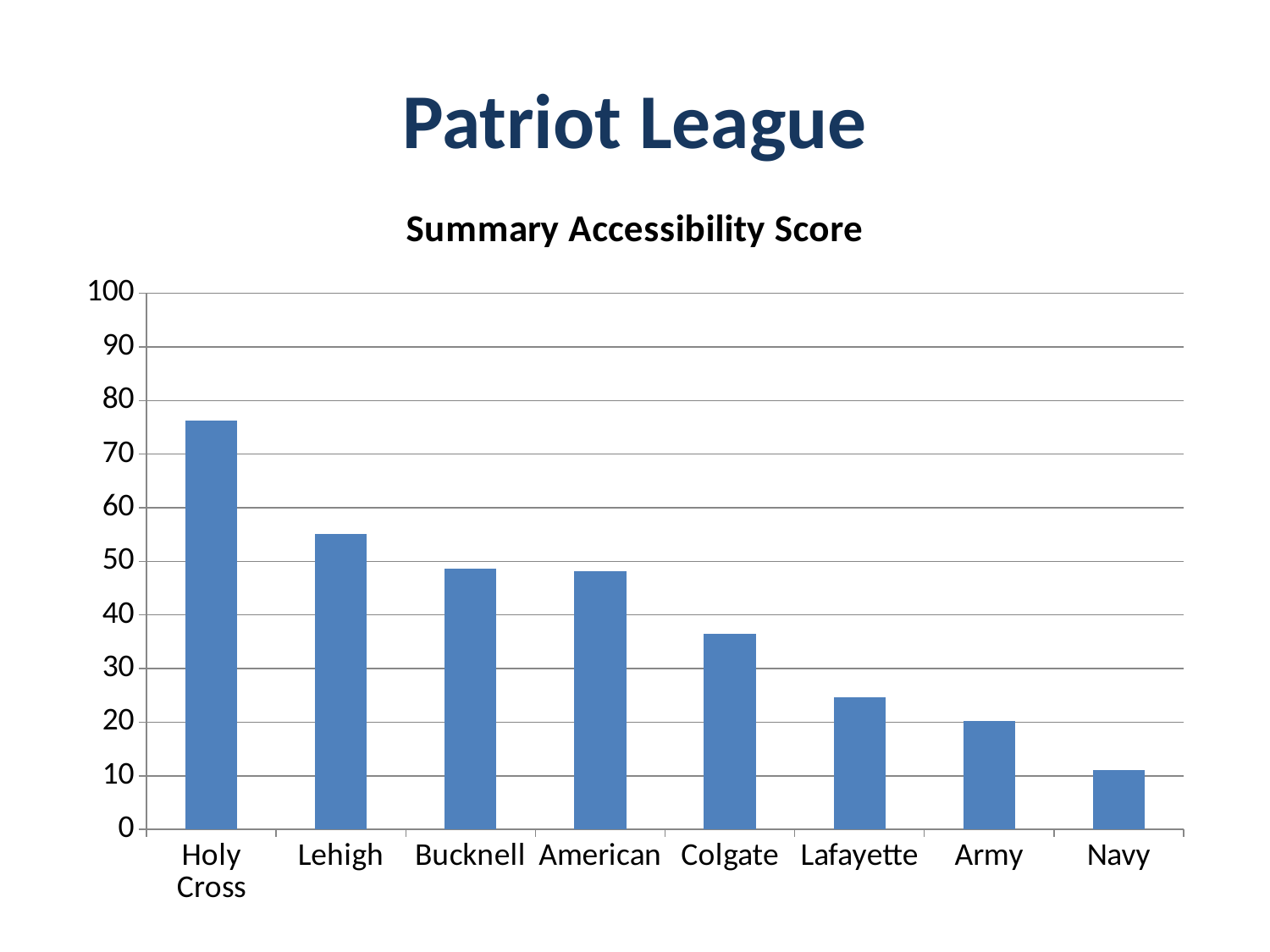
Is the value for Holy Cross greater or less than 70? greater Is the value for Colgate greater or less than 30? greater What is the title of the chart? Summary Accessibility Score Which has a lower score, Lafayette or Army? Army Which school has the lowest Summary Accessibility Score? Navy How many schools are shown on the chart? 8 What type of chart is shown on the slide? bar chart Which has a higher score, Lehigh or Colgate? Lehigh Is the value for Navy greater or less than 20? less Do the values rise or fall moving from left to right along the x axis? fall Which school has the highest Summary Accessibility Score? Holy Cross